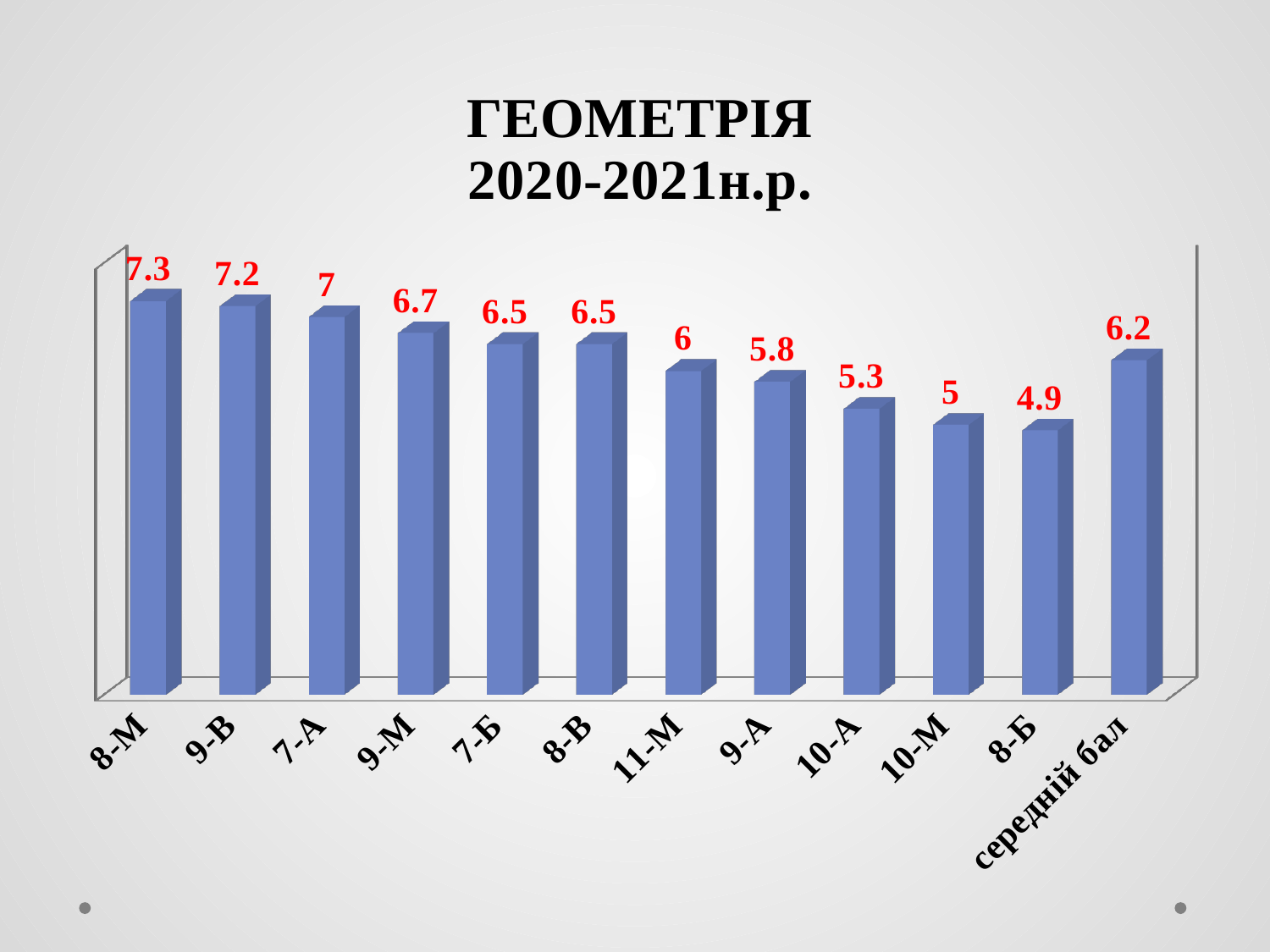
Which is larger, the value for 9-В or the value for 9-А? 9-В What is the value for 8-М? 7.3 What kind of chart is shown on the slide? bar chart How many bars are shown in the chart? 12 Which class has the lowest value? 8-Б What is the value for 10-А? 5.3 Do the values for the classes from 8-М to 8-Б rise or fall along the x axis? fall What is the value shown for середній бал? 6.2 What is the difference between the values for 8-М and 8-Б? 2.4 What is the difference between the value for 7-А and the value for 10-М? 2 Which class has the highest value? 8-М What is the title of the chart? ГЕОМЕТРІЯ 2020-2021н.р.